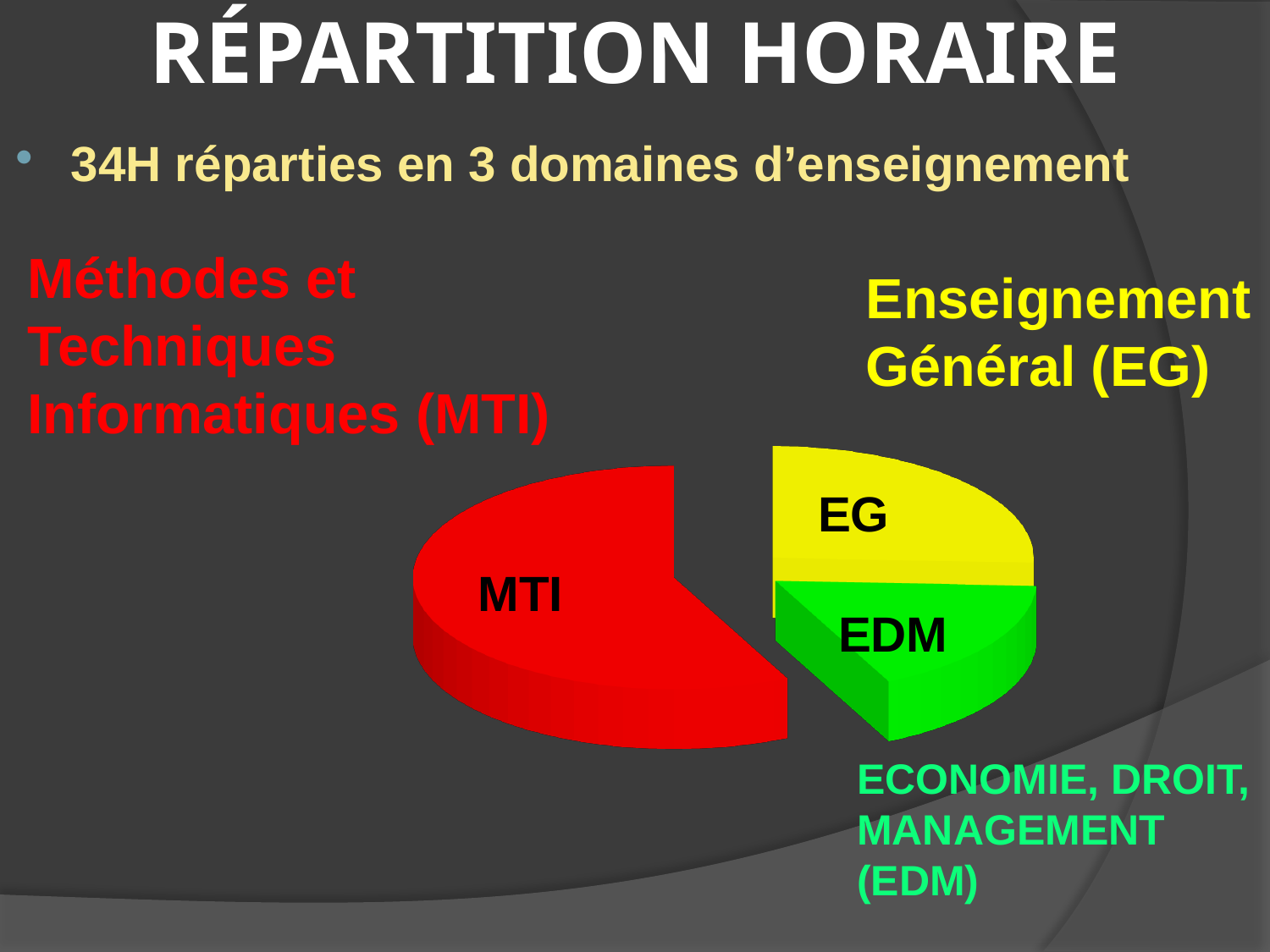
Which is larger in the pie chart, the MTI slice or the EG slice? MTI What colour is the EDM slice of the pie chart? Green How many slices does the pie chart have? 3 What colour is the MTI slice of the pie chart? Red What kind of chart is shown on the slide? Pie chart Which slice of the pie chart is the largest? MTI Which is larger in the pie chart, the MTI slice or the EDM slice? MTI What are the labels of the three slices in the pie chart? MTI, EG, EDM Does the MTI slice take up more or less than half of the pie chart? More